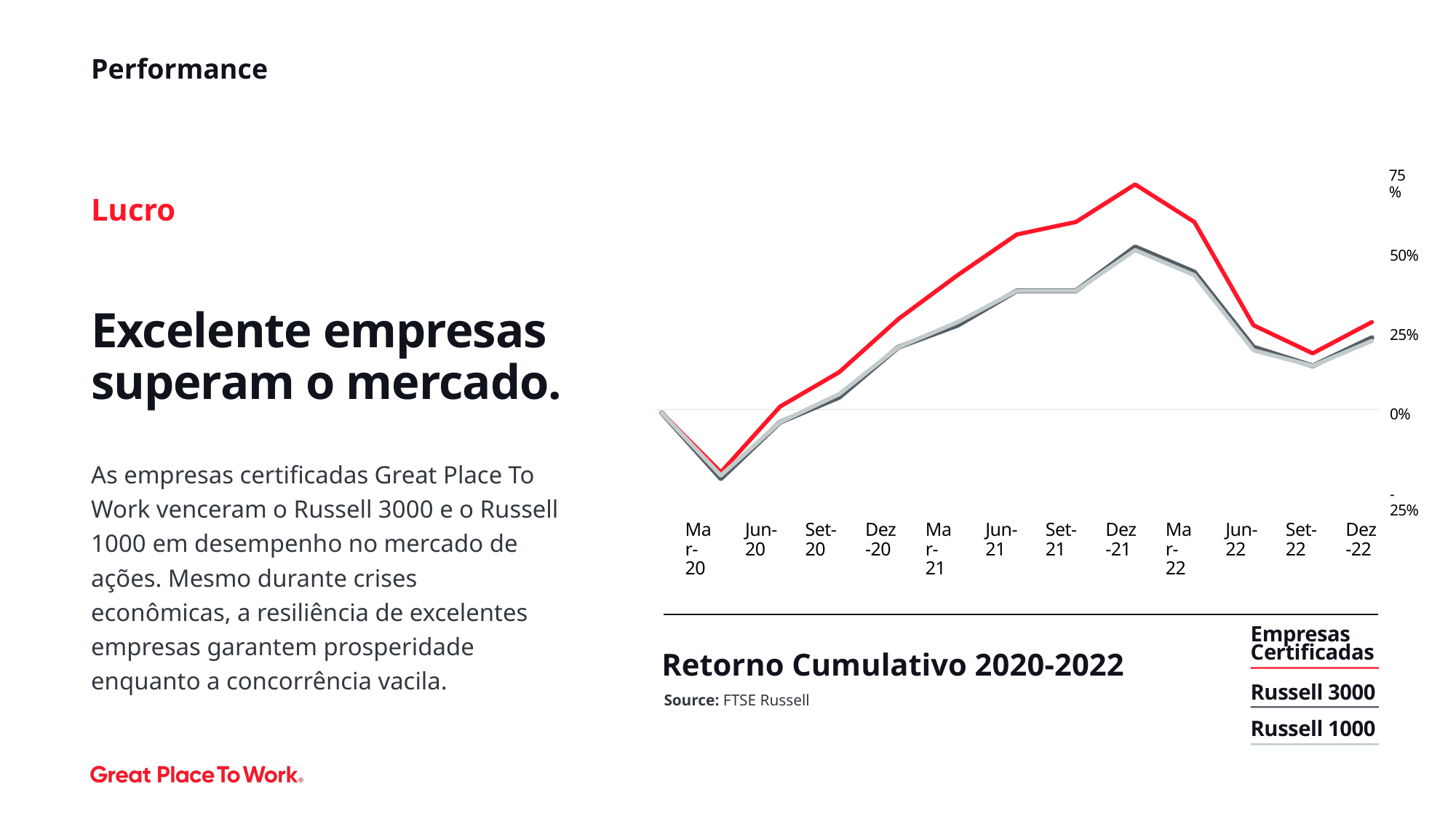
At Dez-21, which is higher: Empresas Certificadas or Russell 3000? Empresas Certificadas At which time point does the Empresas Certificadas line reach its highest value? Dez-21 Is the value for Russell 3000 at Set-21 greater or less than 25%? greater What kind of chart is shown on the slide? line chart How many time points are shown on the x axis of the chart? 12 Do the values of the Empresas Certificadas line rise or fall from Jun-20 to Dez-21? rise How many series does the legend of the chart list? 3 Is the value for Russell 3000 at Set-20 greater or less than 25%? less Is the value for Empresas Certificadas at Dez-21 greater or less than 50%? greater At which time point does the Empresas Certificadas line reach its lowest value? Mar-20 What is the title of the chart? Retorno Cumulativo 2020-2022